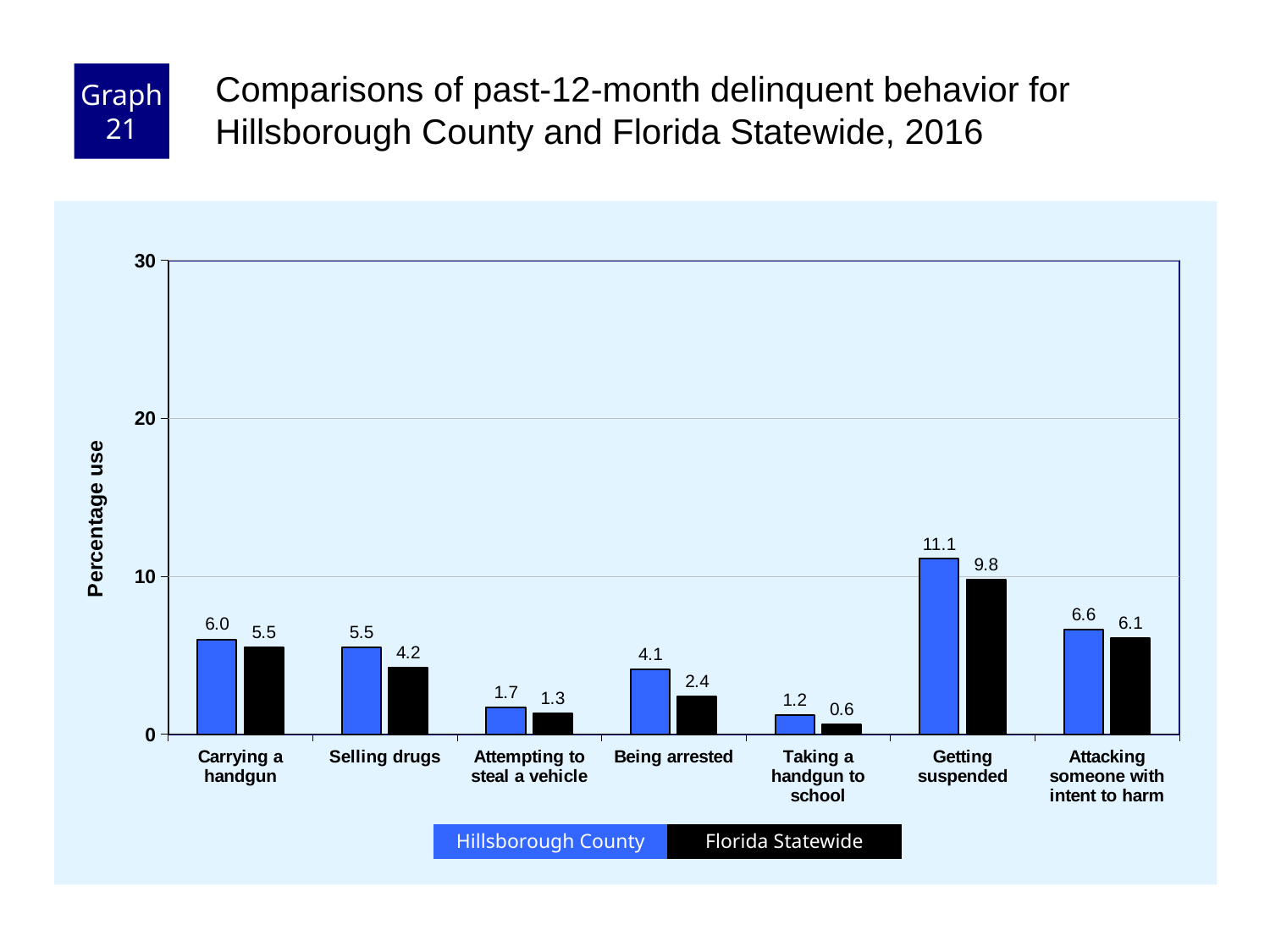
Which category has the lowest Hillsborough County value? Taking a handgun to school Which is larger for Attacking someone with intent to harm: Hillsborough County or Florida Statewide? Hillsborough County What is the Hillsborough County value for Taking a handgun to school? 1.2 What kind of chart is shown? bar chart How many series does the legend list? 2 Is the Hillsborough County value for Getting suspended greater or less than 10? greater What is the Hillsborough County value for Getting suspended? 11.1 What is the Florida Statewide value for Selling drugs? 4.2 Which category has the highest Florida Statewide value? Getting suspended What is the label of the y axis? Percentage use How many categories are shown on the x axis? 7 What is the difference between the Hillsborough County and Florida Statewide values for Being arrested? 1.7